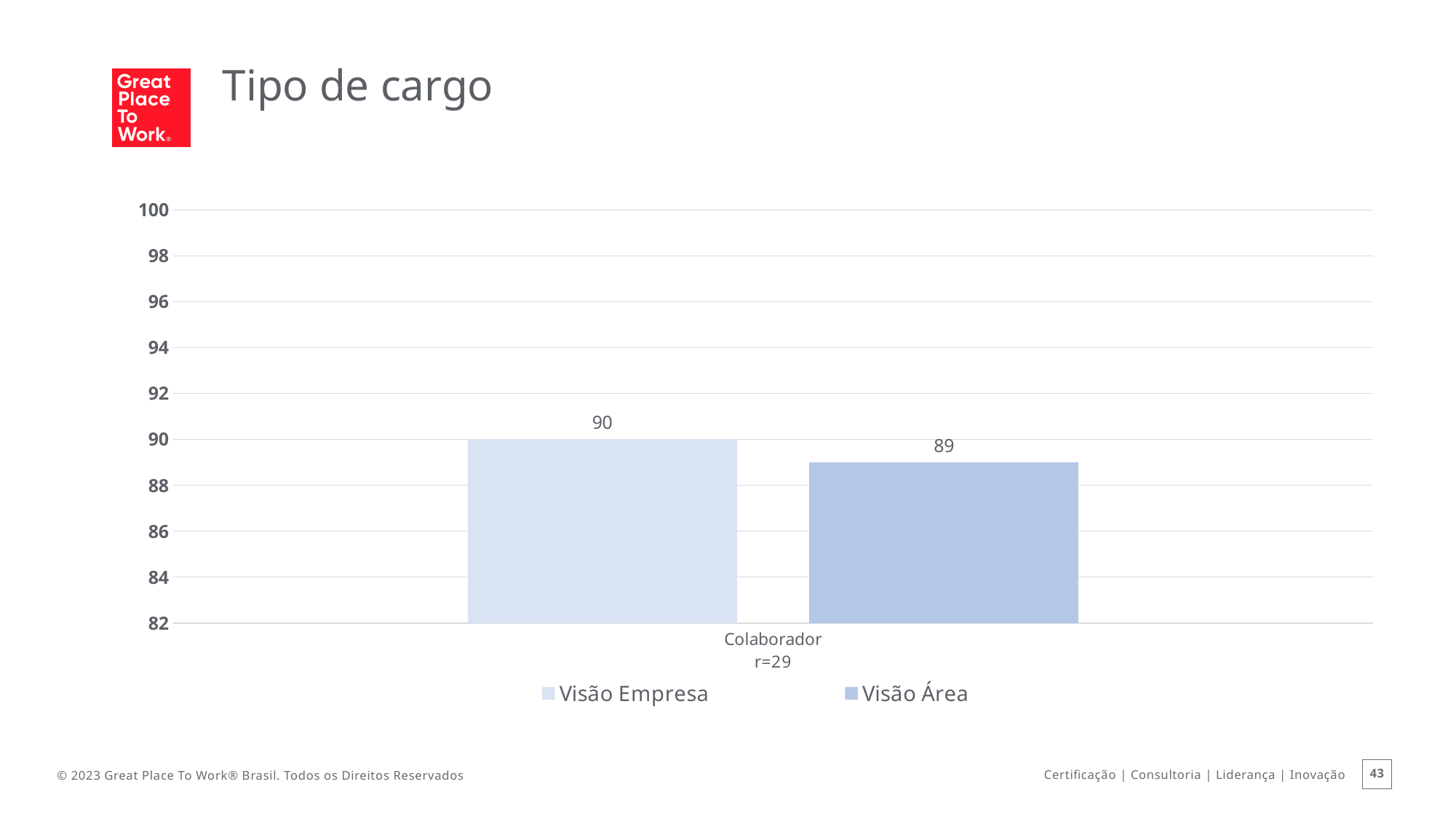
Which series has the higher value for Colaborador, Visão Empresa or Visão Área? Visão Empresa What is the respondent count (r) shown under the Colaborador category? r=29 What is the value for Visão Área for Colaborador? 89 How many series does the legend list? 2 How many categories are shown on the x axis? 1 What is the lowest value shown on the y axis? 82 What kind of chart is shown on the slide? bar chart What is the value for Visão Empresa for Colaborador? 90 What is the difference between the Visão Empresa and Visão Área values for Colaborador? 1 Is the value for Visão Empresa for Colaborador greater or less than 86? greater Is the value for Visão Área for Colaborador greater or less than 90? less What is the title of the slide? Tipo de cargo